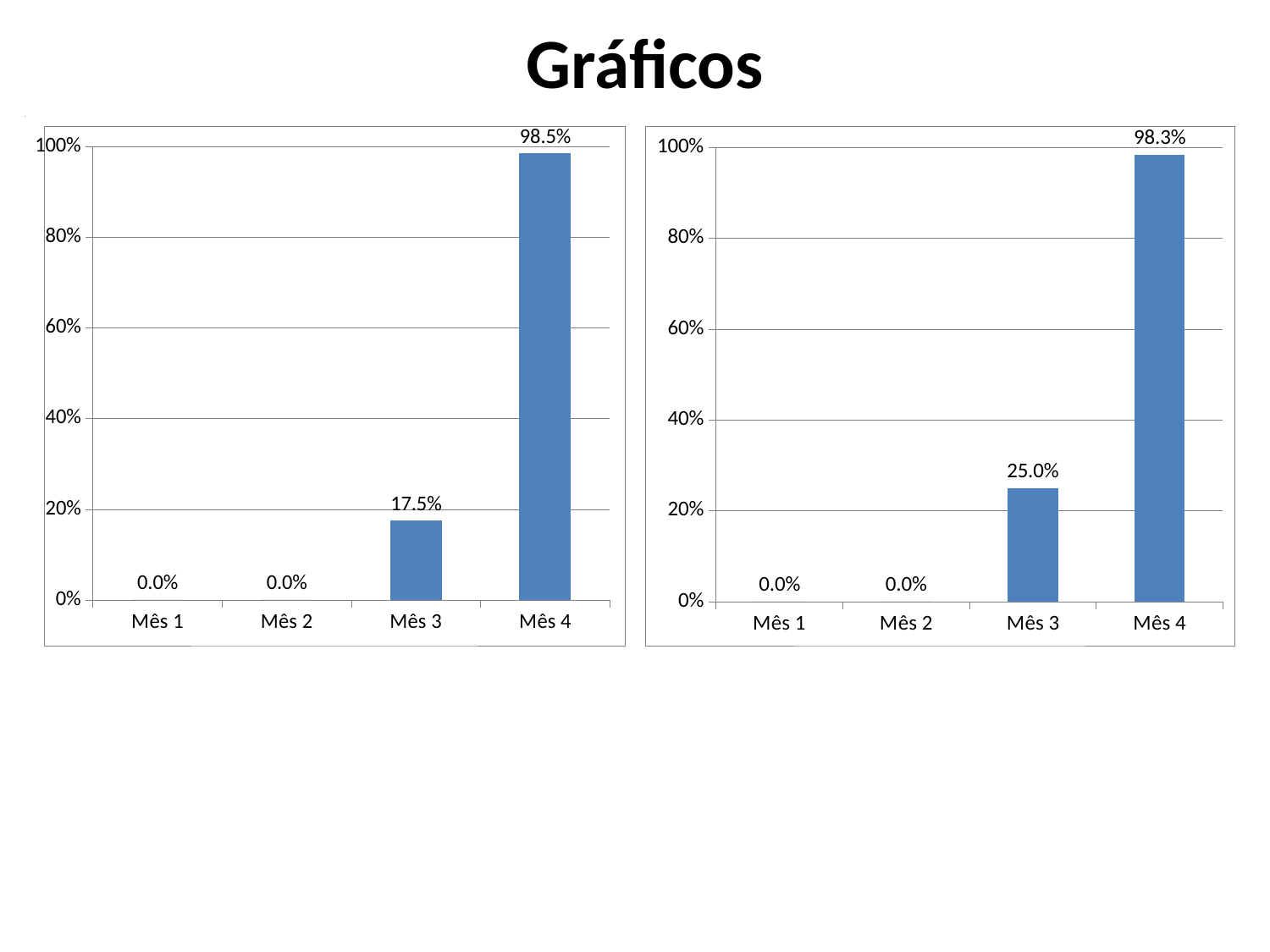
In the left chart, what is the value for Mês 1? 0.0% In the right chart, what is the difference between the values for Mês 4 and Mês 3? 73.3% In the right chart, what is the value for Mês 4? 98.3% In the left chart, how many categories are shown on the x axis? 4 In the right chart, what is the value for Mês 3? 25.0% In the right chart, which category has the highest value? Mês 4 In the left chart, what is the value for Mês 3? 17.5% In the left chart, what is the difference between the values for Mês 4 and Mês 3? 81.0% What kind of chart is the right chart? Bar chart In the right chart, do the values rise or fall from Mês 1 to Mês 4? Rise In the left chart, what is the value for Mês 4? 98.5% Which is larger: the value for Mês 3 in the left chart or the value for Mês 3 in the right chart? Mês 3 in the right chart